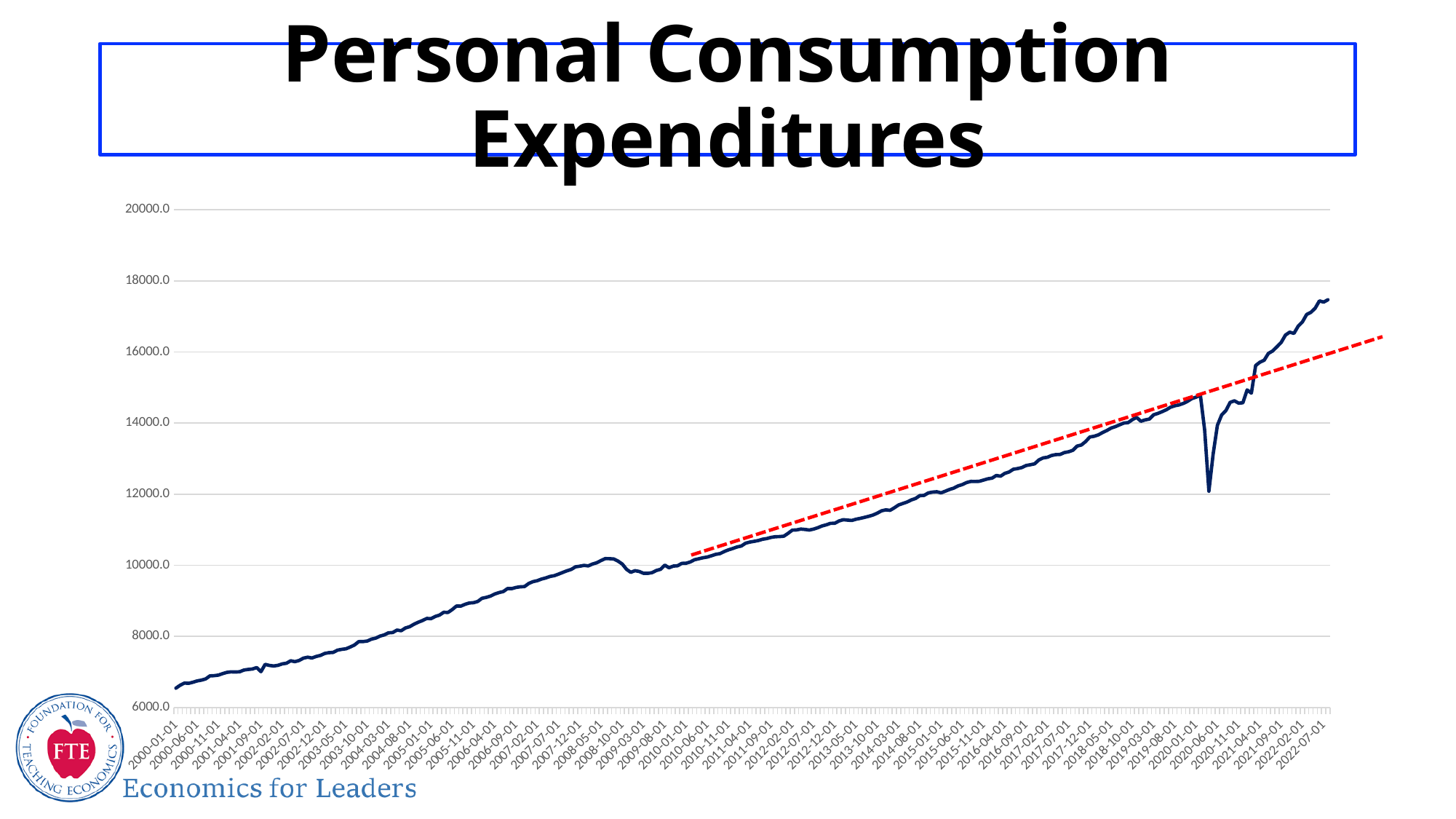
Is the value at 2012-07-01 greater or less than 12000.0? less Is the value at 2000-01-01 greater or less than 8000.0? less Overall, do the values rise or fall from 2000-01-01 to 2022-07-01? rise Is the value at 2022-02-01 greater or less than 16000.0? greater What kind of chart is shown on the slide? line chart What is the title of the chart? Personal Consumption Expenditures Which is larger, the value at 2008-05-01 or the value at 2009-03-01? 2008-05-01 At which end of the x axis does the line reach its lowest value, the start (2000-01-01) or the end (2022-07-01)? the start (2000-01-01) In which year does the line show a sharp, brief drop? 2020